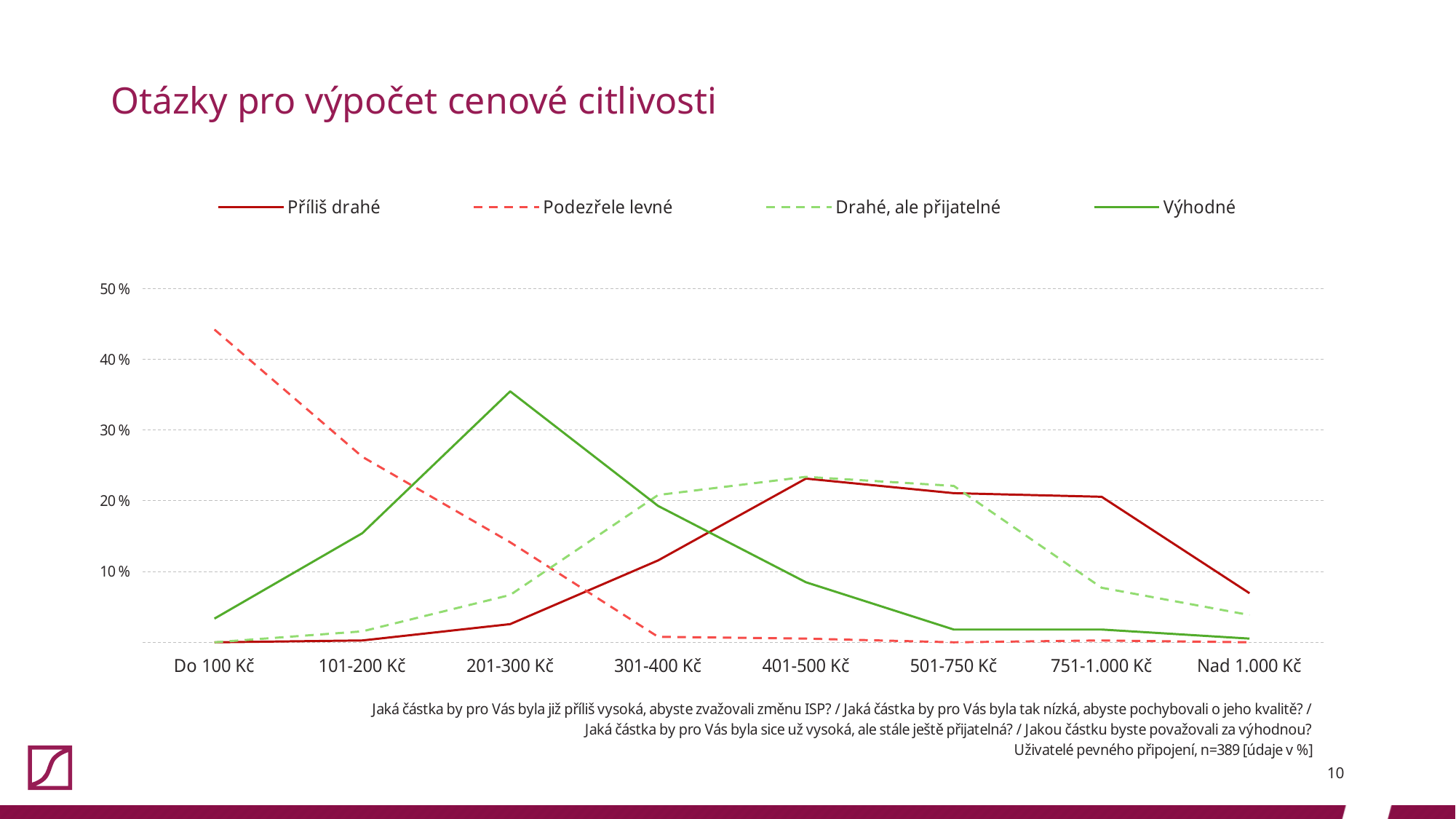
Is the value for 'Příliš drahé' at 'Nad 1.000 Kč' greater or less than 10 %? less Is the value for 'Výhodné' at '201-300 Kč' greater or less than 30 %? greater Does the 'Podezřele levné' series rise or fall as the price categories increase along the x axis? fall How many series does the legend list? 4 For which price category is the value of 'Výhodné' highest? 201-300 Kč What kind of chart is shown on the slide? line chart What is the title of the slide? Otázky pro výpočet cenové citlivosti At '101-200 Kč', which series has the larger value: 'Podezřele levné' or 'Výhodné'? Podezřele levné How many price categories are shown on the x axis? 8 For which price category is the value of 'Podezřele levné' highest? Do 100 Kč At '301-400 Kč', which series has the larger value: 'Výhodné' or 'Příliš drahé'? Výhodné Is the value for 'Podezřele levné' at 'Do 100 Kč' greater or less than 40 %? greater